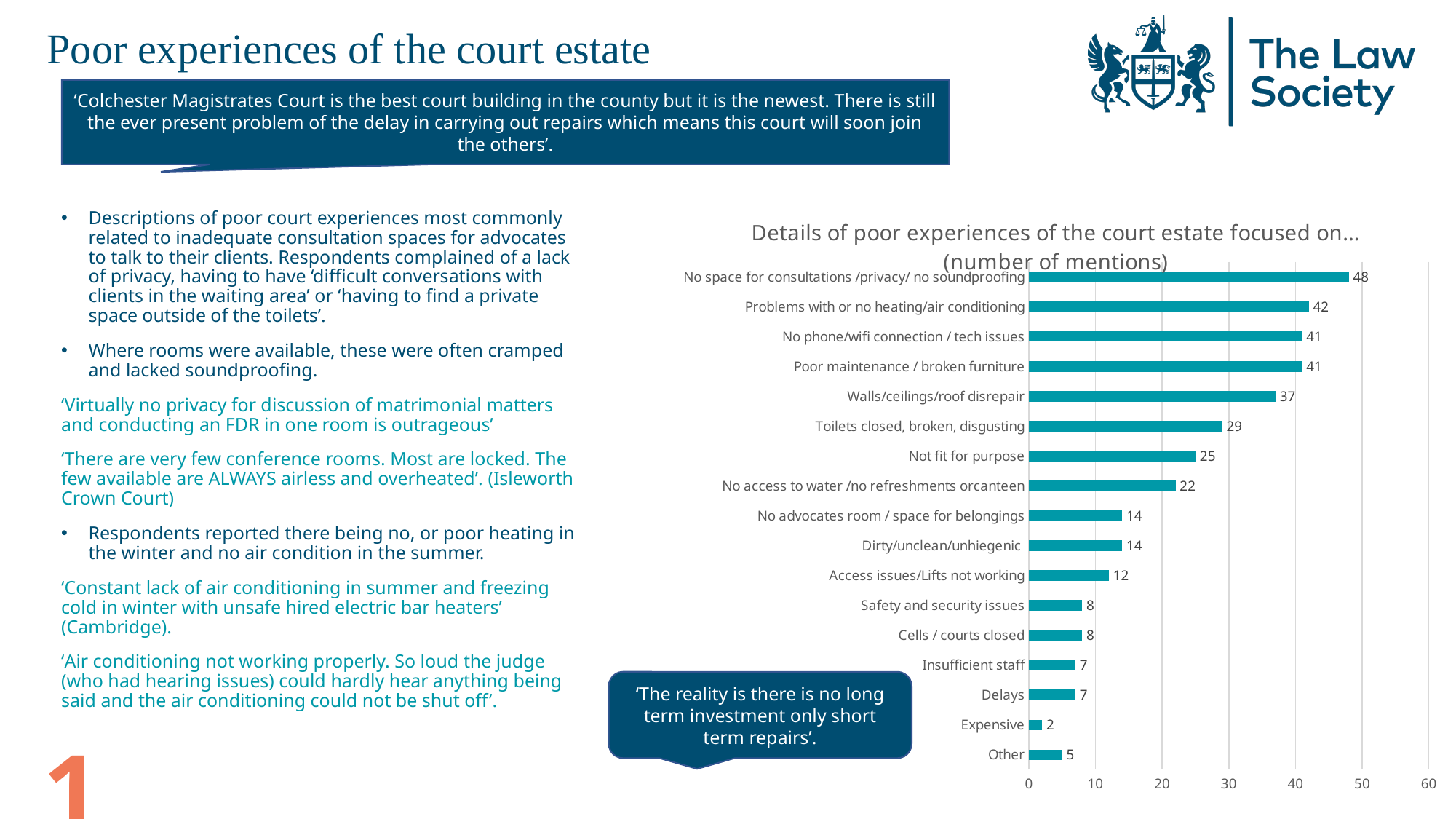
How many categories are shown in the chart? 17 How many mentions does 'No space for consultations /privacy/ no soundproofing' have? 48 How many mentions does 'Access issues/Lifts not working' have? 12 What kind of chart is shown on the slide? Bar chart Which has more mentions, 'Not fit for purpose' or 'No access to water /no refreshments orcanteen'? Not fit for purpose Which category has the lowest number of mentions? Expensive What is the difference in mentions between 'Problems with or no heating/air conditioning' and 'Walls/ceilings/roof disrepair'? 5 What is the number of mentions for 'Toilets closed, broken, disgusting'? 29 What is the title of the chart? Details of poor experiences of the court estate focused on… (number of mentions) Is the value for 'Walls/ceilings/roof disrepair' greater or less than 30? greater Which category has the highest number of mentions? No space for consultations /privacy/ no soundproofing What is the maximum value shown on the chart's horizontal axis? 60